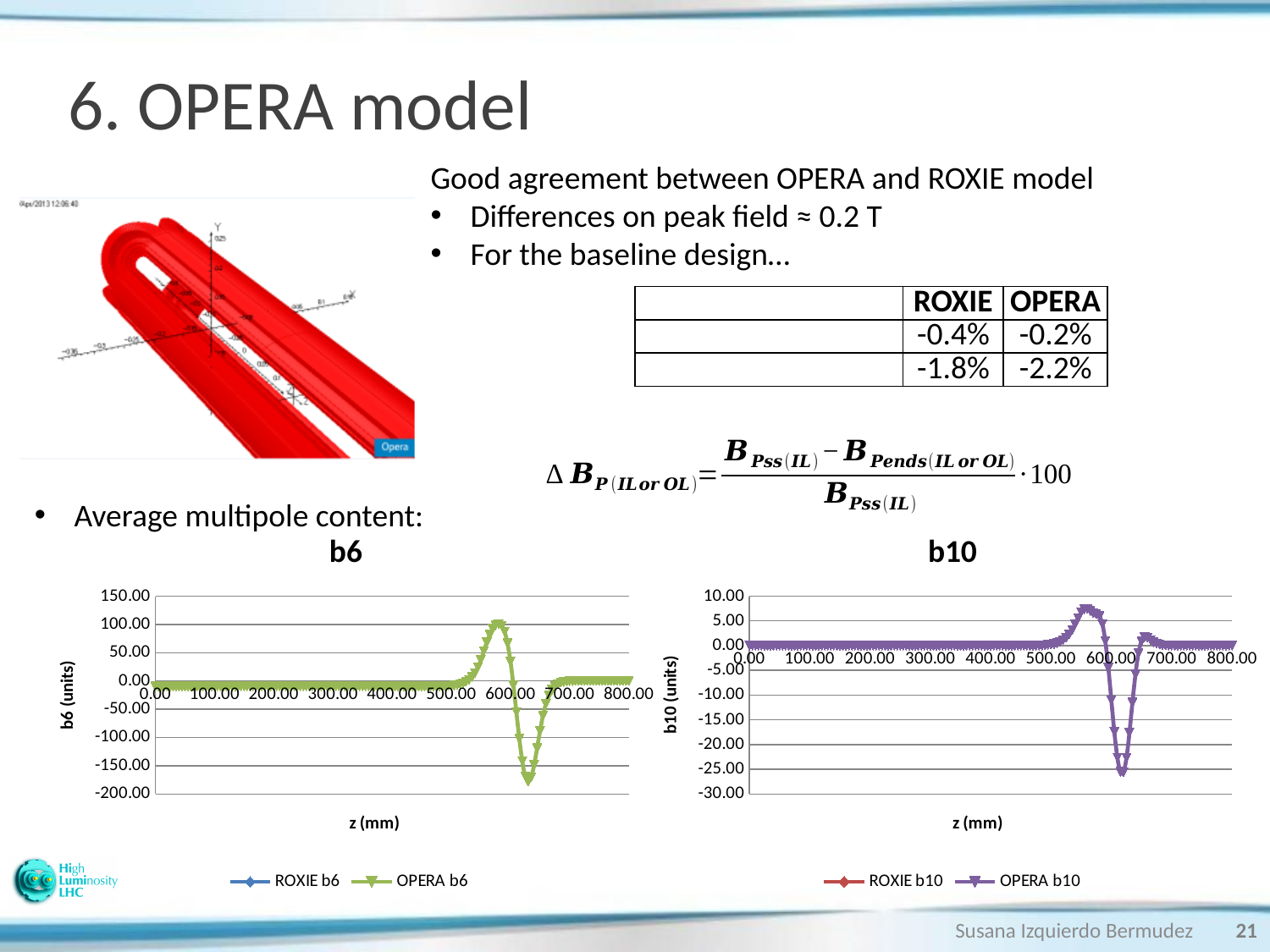
In the b6 chart, is the value of OPERA b6 at z = 300 greater or less than 50? less What is the title of the chart on the left of the slide? b6 How many series does the legend of the b6 chart list? 2 What is the x-axis label of the b10 chart? z (mm) How many series does the legend of the b10 chart list? 2 In the b6 chart, is the lowest value of the OPERA b6 series greater or less than -150? less In the b10 chart, is the value of OPERA b10 at z = 200 greater or less than -5? greater What kind of chart is the b10 chart? line chart What kind of chart is the b6 chart? line chart